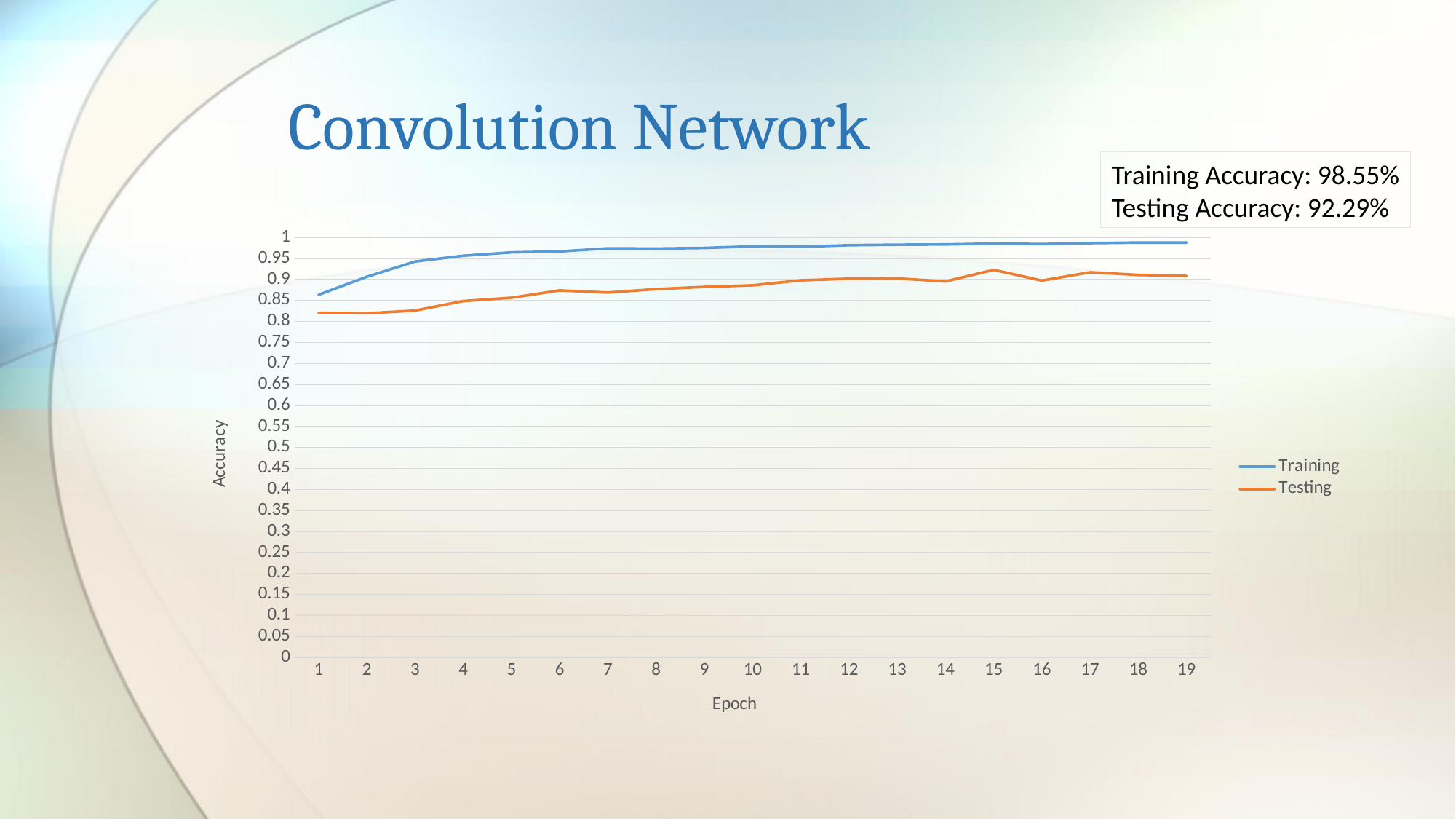
What kind of chart is shown on the slide? Line chart How many epochs are plotted along the x axis? 19 Which colour is used for the Testing series? Orange Is the Training accuracy at epoch 19 greater or less than 0.95? greater At which epoch is the Training accuracy lowest? 1 What is the label of the y axis? Accuracy At which epoch does the Testing series reach its highest accuracy? 15 At epoch 1, which series has the higher accuracy, Training or Testing? Training How many series does the legend list? 2 Is the Testing accuracy at epoch 1 greater or less than 0.85? less Is the Training accuracy at epoch 1 greater or less than 0.8? greater Does the Training series generally rise or fall as the epoch increases? Rise